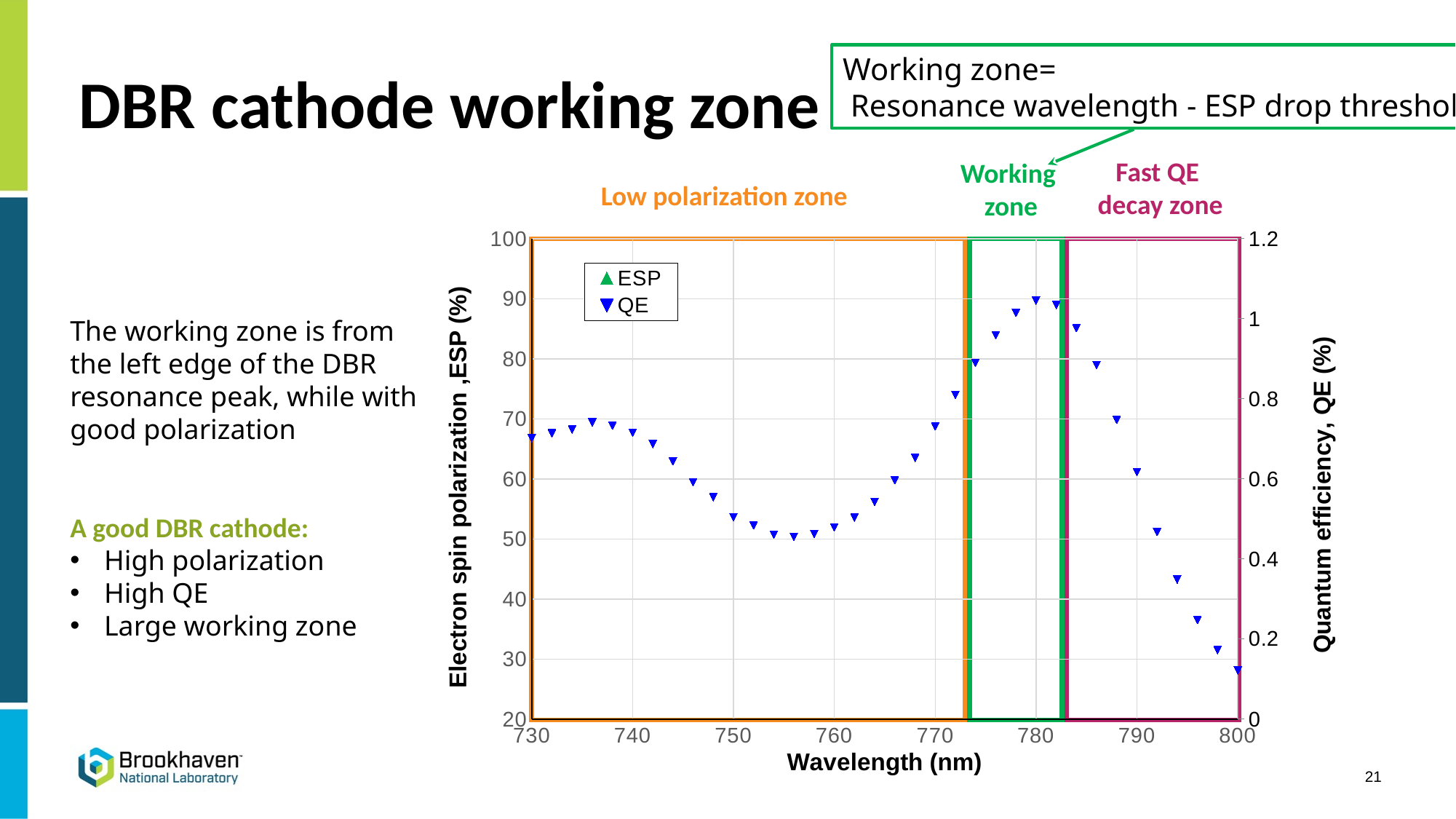
Which has the larger QE value, 740 nm or 760 nm? 740 nm What is the title of the x axis of the chart? Wavelength (nm) At which wavelength on the x axis is the QE value lowest? 800 On the right-hand QE axis, is the QE value at 780 nm greater or less than 0.8? greater On the right-hand QE axis, is the QE value at 756 nm greater or less than 0.6? less Do the QE values rise or fall as the wavelength increases from 760 nm to 780 nm? rise Which has the larger QE value, 770 nm or 790 nm? 770 nm Do the QE values rise or fall as the wavelength increases from 780 nm to 800 nm? fall What are the two series named in the chart legend? ESP and QE How many series does the chart legend list? 2 What kind of chart is shown on the slide? scatter chart On the right-hand QE axis, is the QE value at 800 nm greater or less than 0.2? less